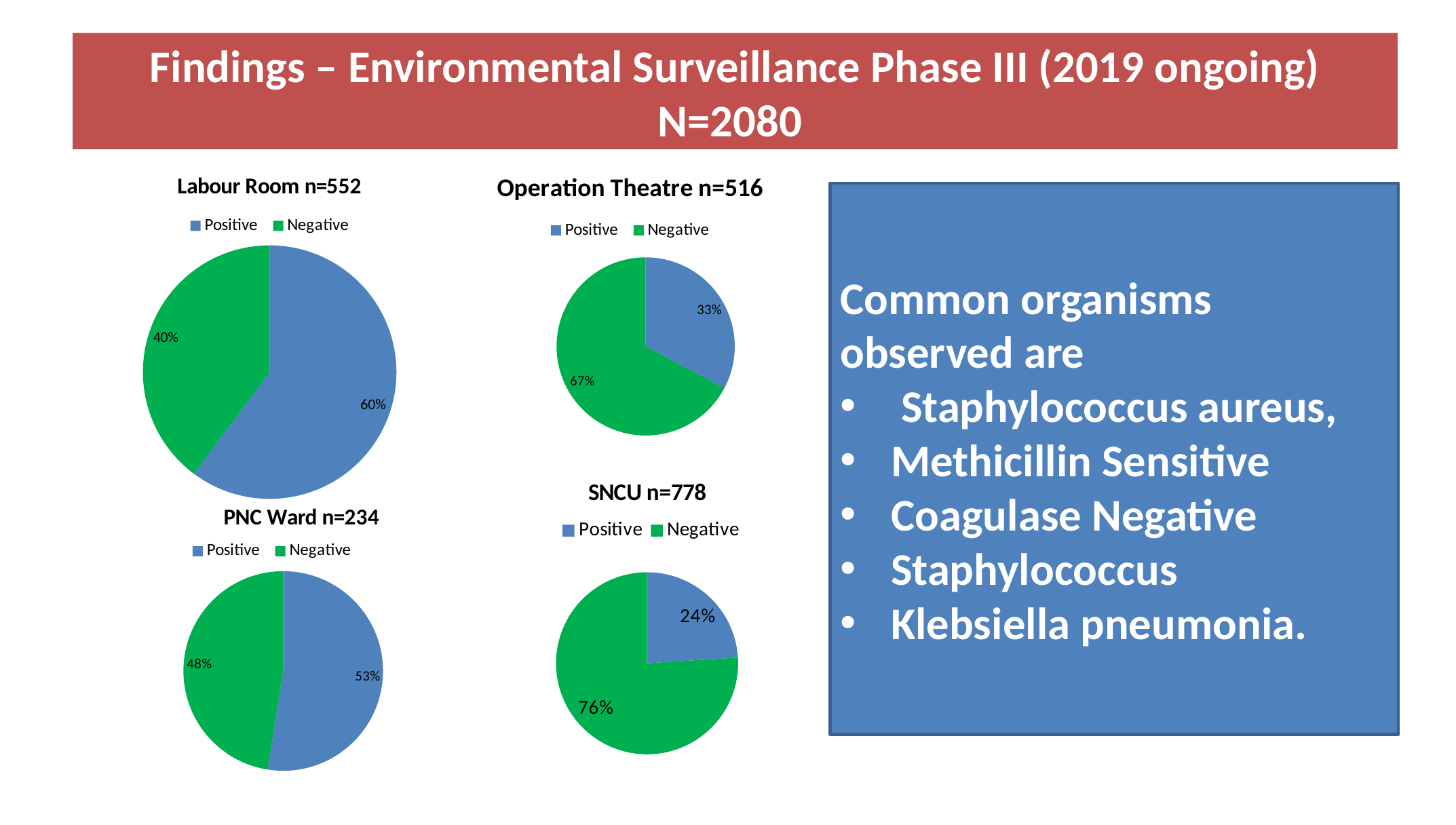
In the "Operation Theatre n=516" chart, what share of the pie is Negative? 67% What kind of chart is the "PNC Ward n=234" chart? Pie chart In the "Labour Room n=552" chart, which slice is the largest? Positive How many series does the legend of the "SNCU n=778" chart list? 2 In the "Operation Theatre n=516" chart, what is the difference between the Negative and Positive shares? 34% In the "SNCU n=778" chart, what share of the pie is Positive? 24% In the "Labour Room n=552" chart, what share of the pie is Positive? 60% In the "SNCU n=778" chart, which slice is larger, Positive or Negative? Negative